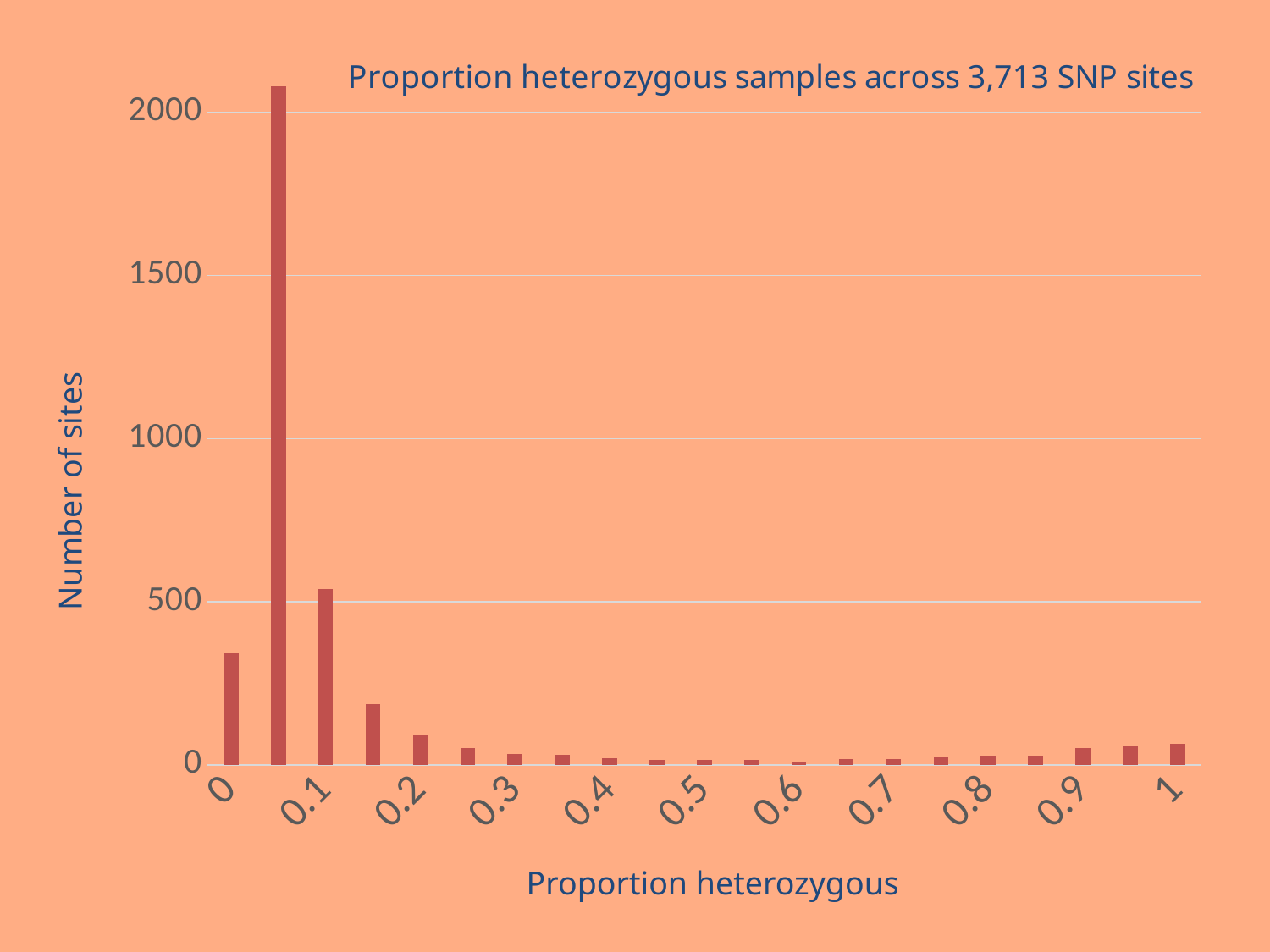
How many labelled tick values are shown on the horizontal axis? 11 Is the tallest bar in the chart greater or less than 1500? greater What kind of chart is shown on the slide? bar chart Do the bar heights generally rise or fall as proportion heterozygous goes from 0.1 to 0.6? fall What is the label on the vertical axis of the chart? Number of sites Is the number of sites at proportion heterozygous 0.2 greater or less than 500? less What is the title of the chart? Proportion heterozygous samples across 3,713 SNP sites Is the number of sites at proportion heterozygous 0.1 greater or less than 500? greater Which has more sites: proportion heterozygous 0.1 or 0.2? 0.1 Which has more sites: proportion heterozygous 0 or 0.1? 0.1